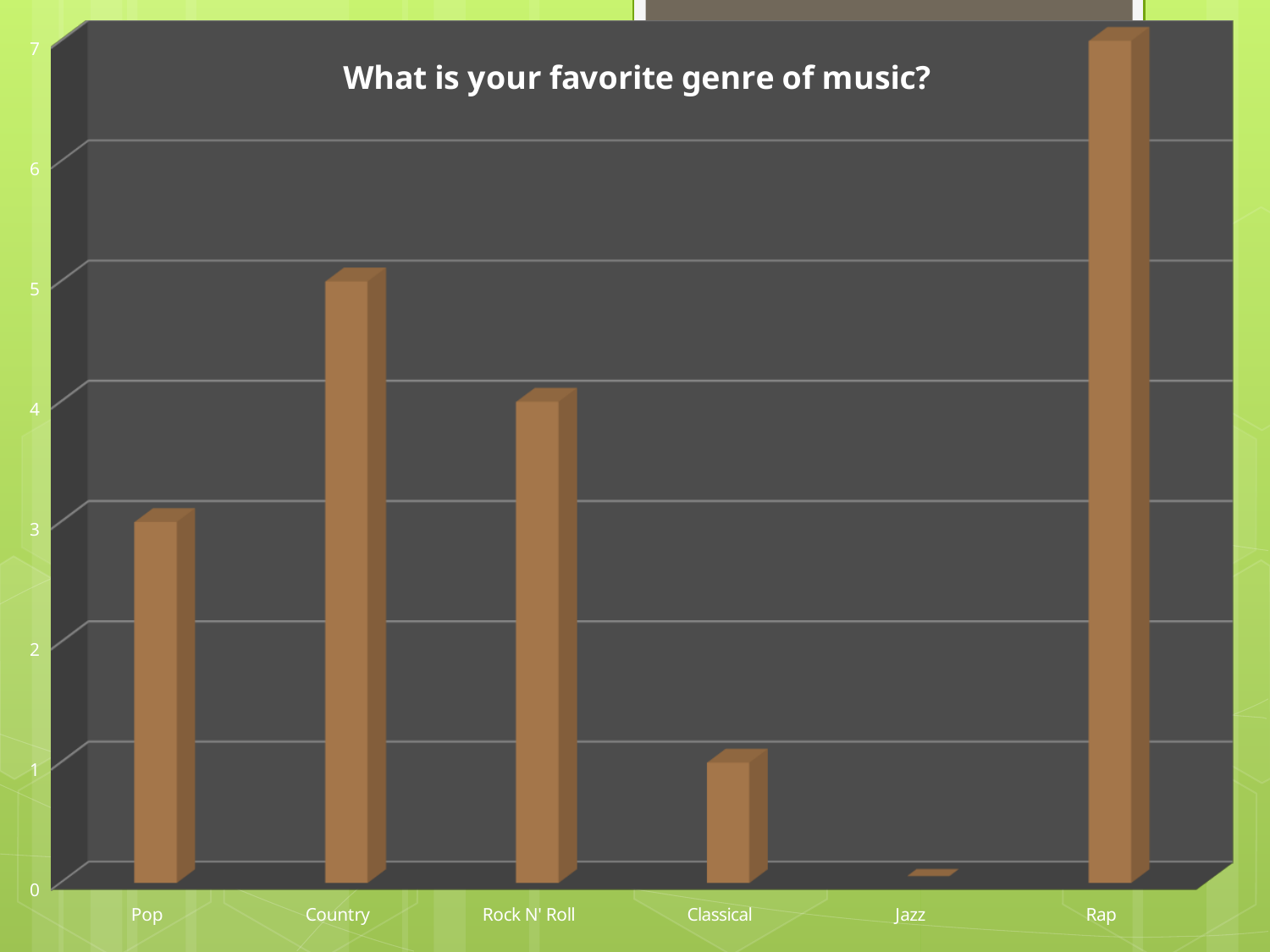
How many music genres are shown on the x axis? 6 Which genre has the highest value? Rap What is the value for Pop? 3 What is the value for Rap? 7 What is the title of the chart? What is your favorite genre of music? What is the value for Country? 5 Is the value for Rock N' Roll greater or less than 2? greater What is the value for Classical? 1 What is the difference between the value for Rap and the value for Pop? 4 Which is larger, the value for Country or the value for Rock N' Roll? Country Which genre has the lowest value? Jazz What type of chart is shown on the slide? bar chart